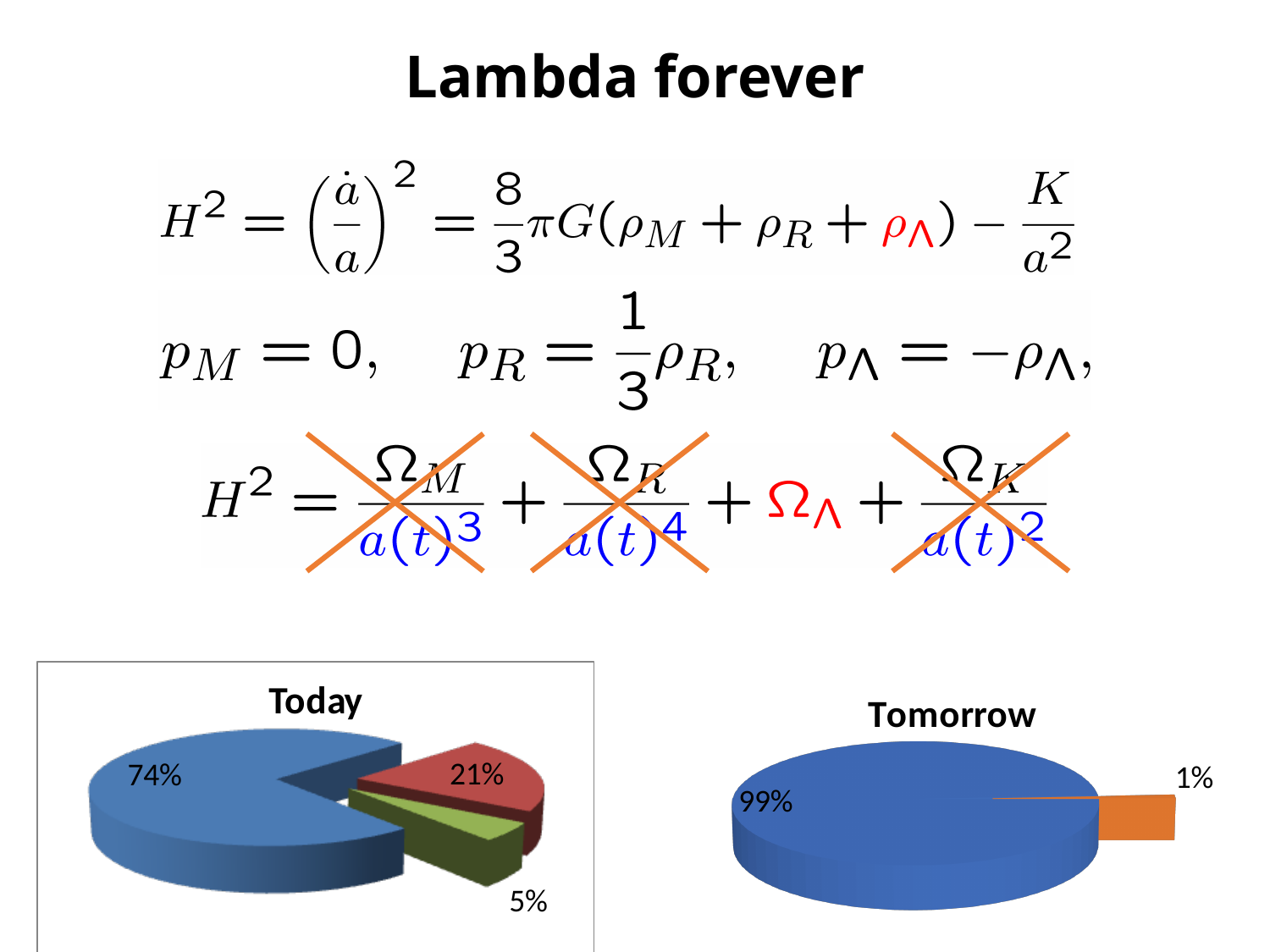
What kind of chart is the "Tomorrow" chart? pie chart In the "Tomorrow" chart, what percentage is shown for the orange slice? 1% In the "Today" chart, what percentage is shown for the red slice? 21% In the "Today" chart, which slice is the smallest? the green slice (5%) How many slices does the "Tomorrow" pie chart have? 2 In the "Today" chart, what percentage is shown for the green slice? 5% In the "Today" chart, what is the difference between the blue slice and the red slice? 53% In the "Today" chart, which is larger, the red slice or the green slice? the red slice In the "Tomorrow" chart, what percentage is shown for the blue slice? 99% How many slices does the "Today" pie chart have? 3 What kind of chart is the "Today" chart? pie chart In the "Today" chart, what percentage is shown for the blue slice? 74%